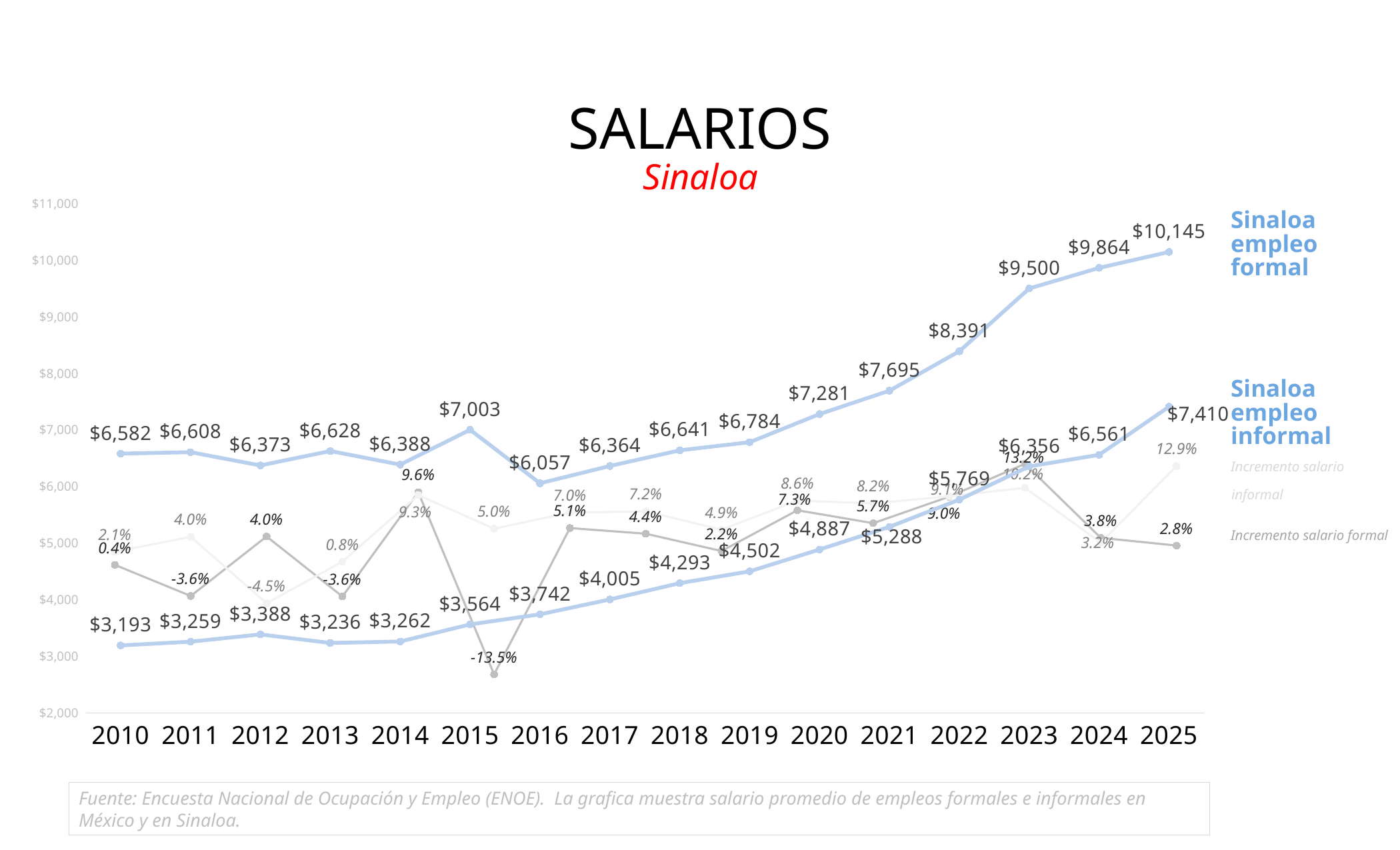
In which year is the Sinaloa empleo informal salary highest? 2025 What is the Sinaloa empleo formal salary for 2016? $6,057 What is the Sinaloa empleo informal salary for 2010? $3,193 Is the Sinaloa empleo formal salary for 2023 greater or less than $9,000? greater Does the Sinaloa empleo informal salary rise or fall from 2015 to 2025? rise What kind of chart is shown on the slide? line chart Which is larger, the Sinaloa empleo formal salary in 2015 or in 2016? 2015 What is the Sinaloa empleo formal salary for 2025? $10,145 What is the difference between the Sinaloa empleo formal and Sinaloa empleo informal salaries in 2025? $2,735 In which year is the Sinaloa empleo formal salary lowest? 2016 What is the Sinaloa empleo informal salary for 2021? $5,288 How many years are shown on the x axis? 16